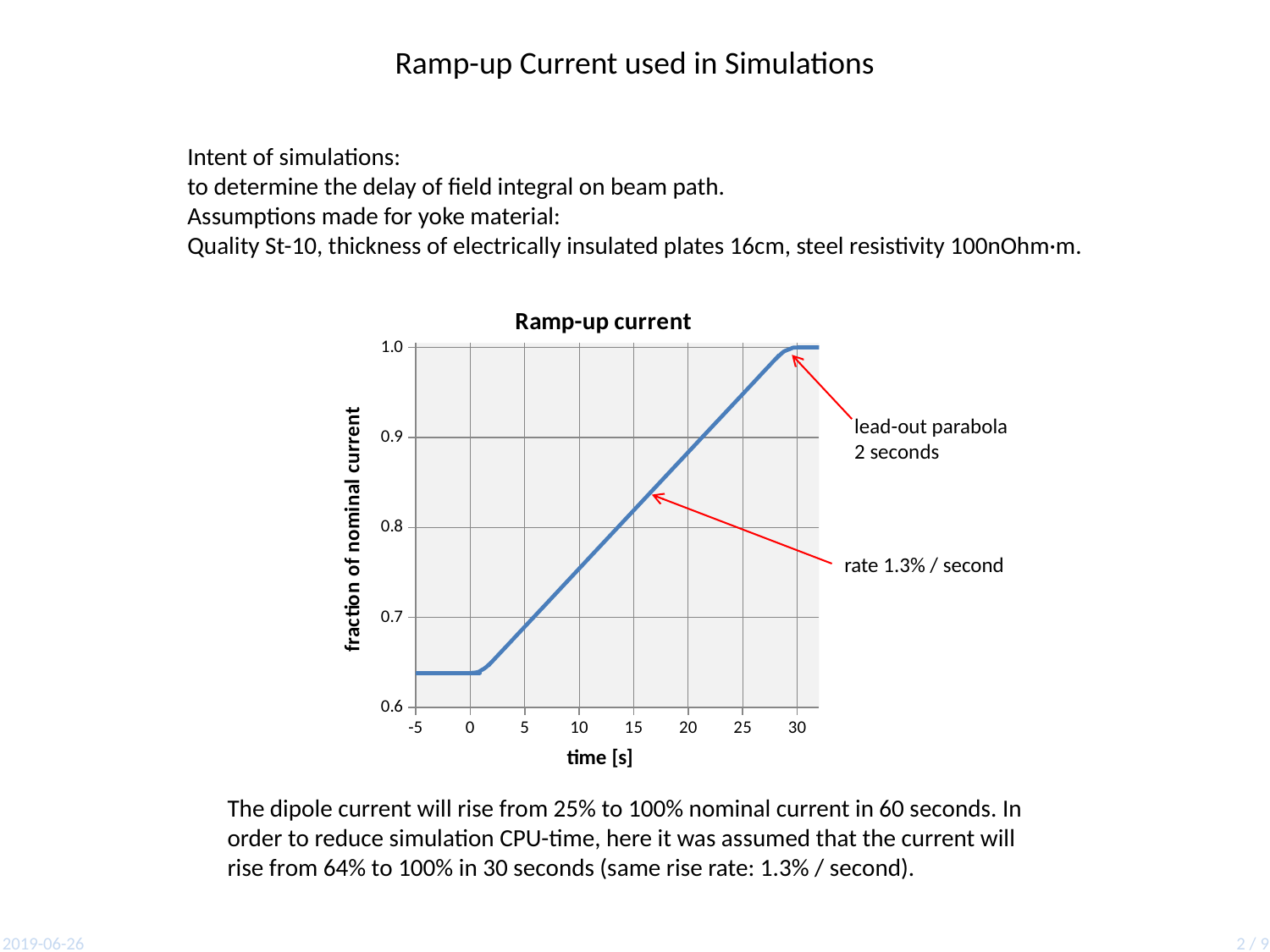
In the "Ramp-up current" chart, what fraction of nominal current is reached at 30 s? 1.0 What kind of chart is the "Ramp-up current" chart? line chart In the "Ramp-up current" chart, which is larger: the value at 10 s or the value at 25 s? 25 s According to the annotation on the "Ramp-up current" chart, what is the rise rate of the linear section? 1.3% / second In the "Ramp-up current" chart, at what time does the curve reach its highest value of 1.0? 30 s What is the label of the y axis of the "Ramp-up current" chart? fraction of nominal current In the "Ramp-up current" chart, is the value at 25 s greater or less than 0.9? greater In the "Ramp-up current" chart, is the value at 10 s greater or less than 0.7? greater In the "Ramp-up current" chart, is the value at -5 s greater or less than 0.7? less In the "Ramp-up current" chart, does the fraction of nominal current rise or fall as time increases from 0 s to 30 s? rise